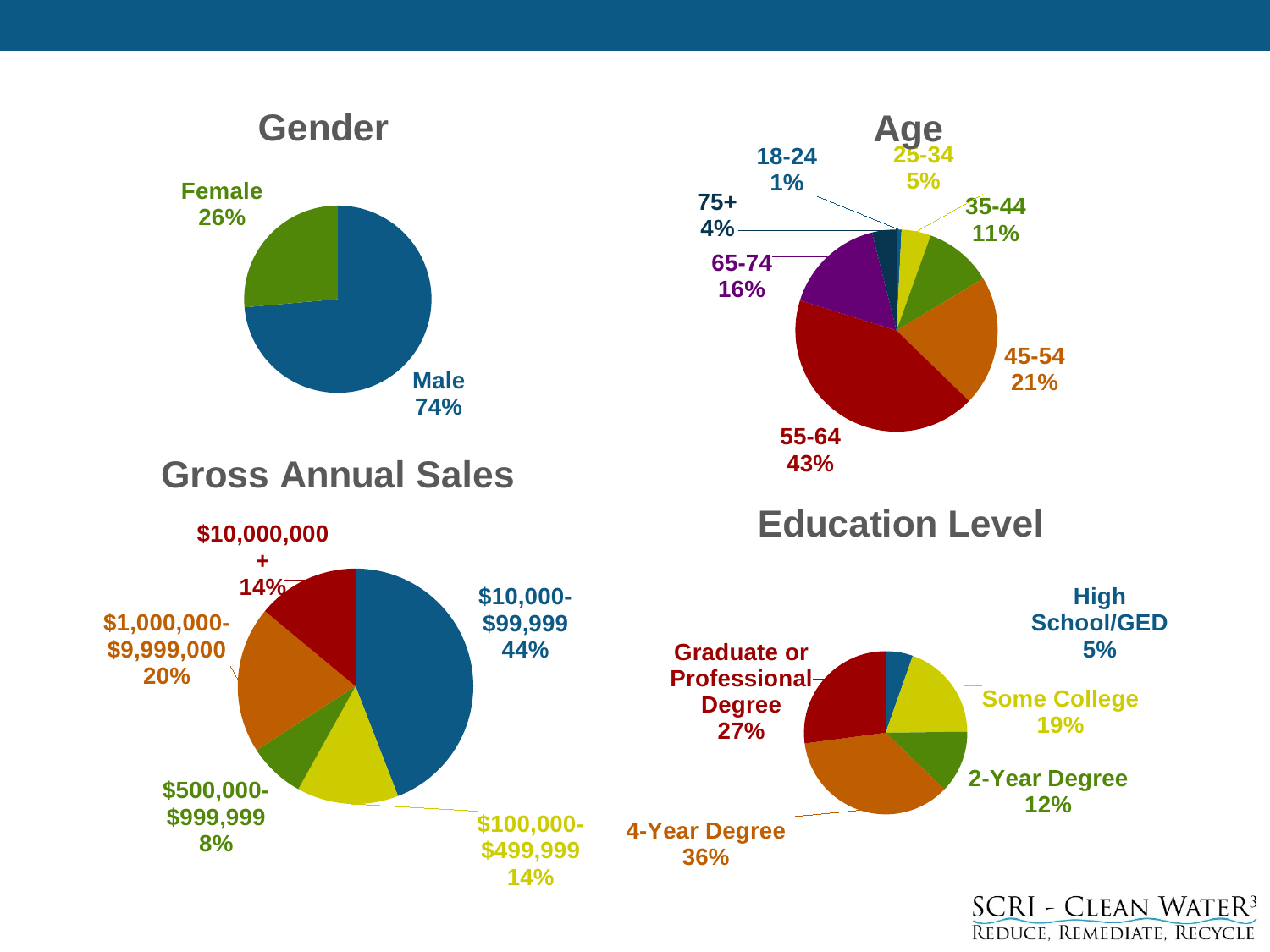
In the Gross Annual Sales chart, what is the difference between the $10,000-$99,999 share and the $500,000-$999,999 share? 36% In the Gender chart, what percentage is Male? 74% In the Age chart, what is the difference between the 45-54 share and the 65-74 share? 5% In the Age chart, what percentage is the 55-64 group? 43% What type of chart is the Gender chart? Pie chart In the Gross Annual Sales chart, what percentage is $1,000,000-$9,999,000? 20% In the Education Level chart, which is larger: Some College or 2-Year Degree? Some College In the Education Level chart, how many categories are shown? 5 In the Age chart, how many age groups are shown? 7 In the Gross Annual Sales chart, which category has the largest share? $10,000-$99,999 In the Education Level chart, what percentage is 4-Year Degree? 36% In the Age chart, which age group has the smallest share? 18-24